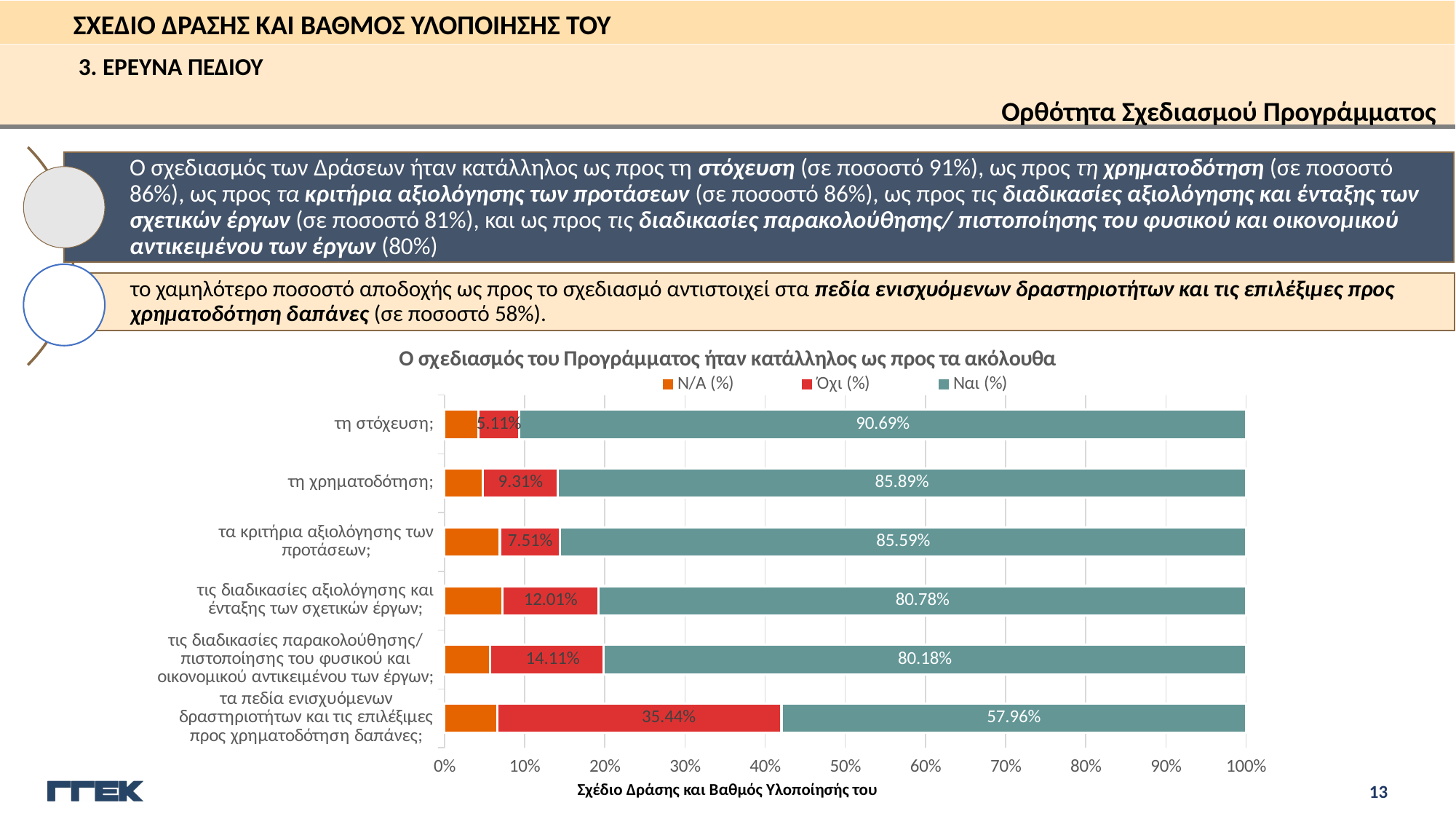
How many series does the legend list? 3 What is the difference between the Ναι (%) value for τη στόχευση; and the Ναι (%) value for τα πεδία ενισχυόμενων δραστηριοτήτων και τις επιλέξιμες προς χρηματοδότηση δαπάνες;? 32.73 percentage points What kind of chart is shown on the slide? Stacked bar chart What is the value of Όχι (%) for τα πεδία ενισχυόμενων δραστηριοτήτων και τις επιλέξιμες προς χρηματοδότηση δαπάνες;? 35.44% Which is larger: the Όχι (%) value for τις διαδικασίες παρακολούθησης/ πιστοποίησης του φυσικού και οικονομικού αντικειμένου των έργων; or for τις διαδικασίες αξιολόγησης και ένταξης των σχετικών έργων;? τις διαδικασίες παρακολούθησης/ πιστοποίησης του φυσικού και οικονομικού αντικειμένου των έργων; Which category has the lowest Ναι (%) value? τα πεδία ενισχυόμενων δραστηριοτήτων και τις επιλέξιμες προς χρηματοδότηση δαπάνες; What is the value of Όχι (%) for τη χρηματοδότηση;? 9.31% Which category has the highest Ναι (%) value? τη στόχευση; What is the value of Ναι (%) for τη στόχευση;? 90.69% What is the value of Ναι (%) for τις διαδικασίες αξιολόγησης και ένταξης των σχετικών έργων;? 80.78% Is the N/A (%) value for τη στόχευση; greater or less than 10%? less How many categories are shown on the chart? 6